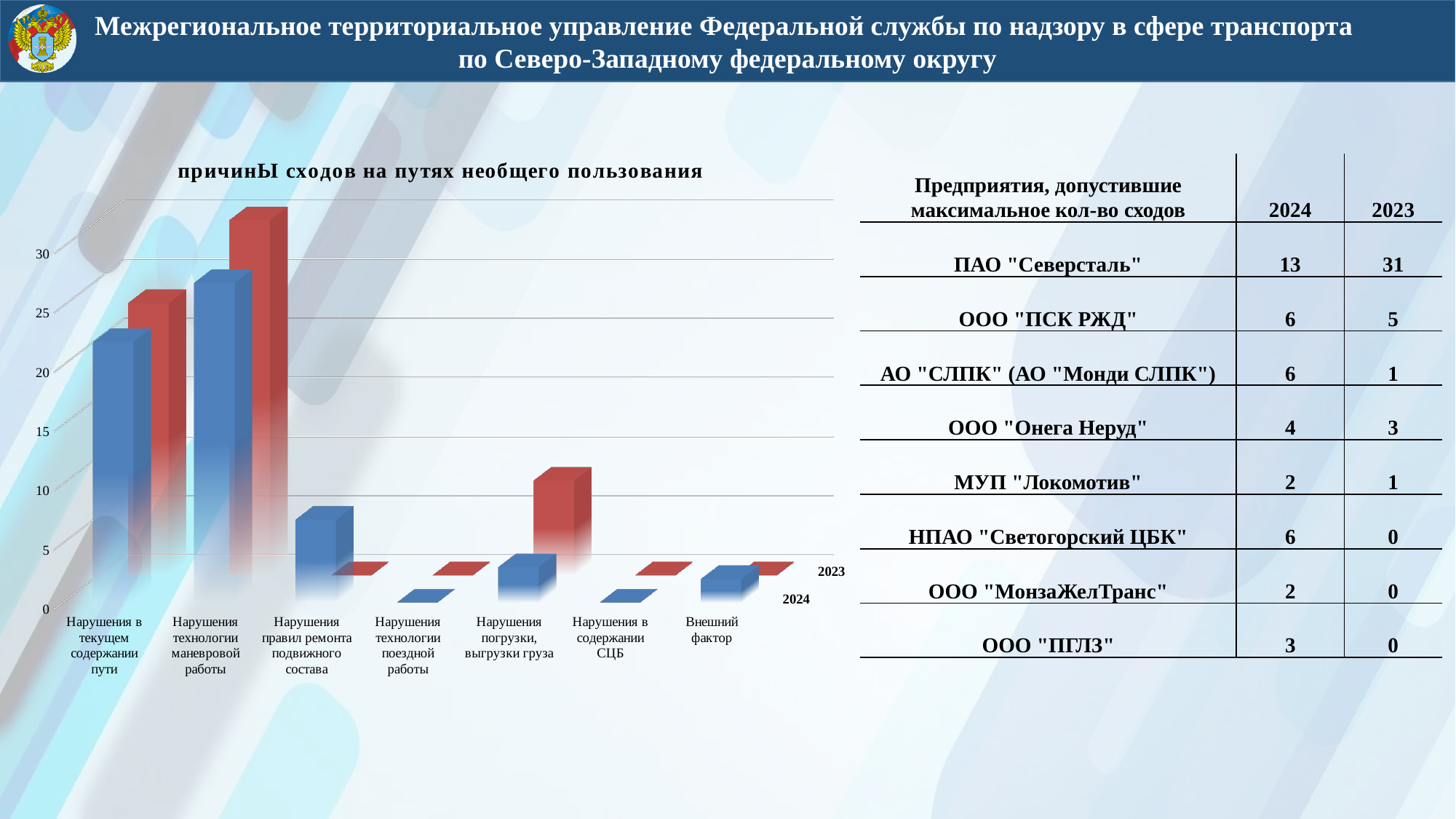
What kind of chart is shown on the slide? bar chart Is the 2024 value for Нарушения правил ремонта подвижного состава greater or less than 15? less How many series does the chart show? 2 For Нарушения погрузки, выгрузки груза, which year has the larger value, 2023 or 2024? 2023 What is the title of the chart on the slide? причинЫ сходов на путях необщего пользования Which category has the highest value for 2023 in the chart? Нарушения технологии маневровой работы Is the 2023 value for Нарушения технологии маневровой работы greater or less than 25? greater How many categories (causes) are shown along the x axis of the chart? 7 Which colour represents the 2023 series in the chart? red Which category has the highest value for 2024 in the chart? Нарушения технологии маневровой работы For Нарушения правил ремонта подвижного состава, which year has the larger value, 2023 or 2024? 2024 Is the 2024 value for Нарушения в текущем содержании пути greater or less than 15? greater